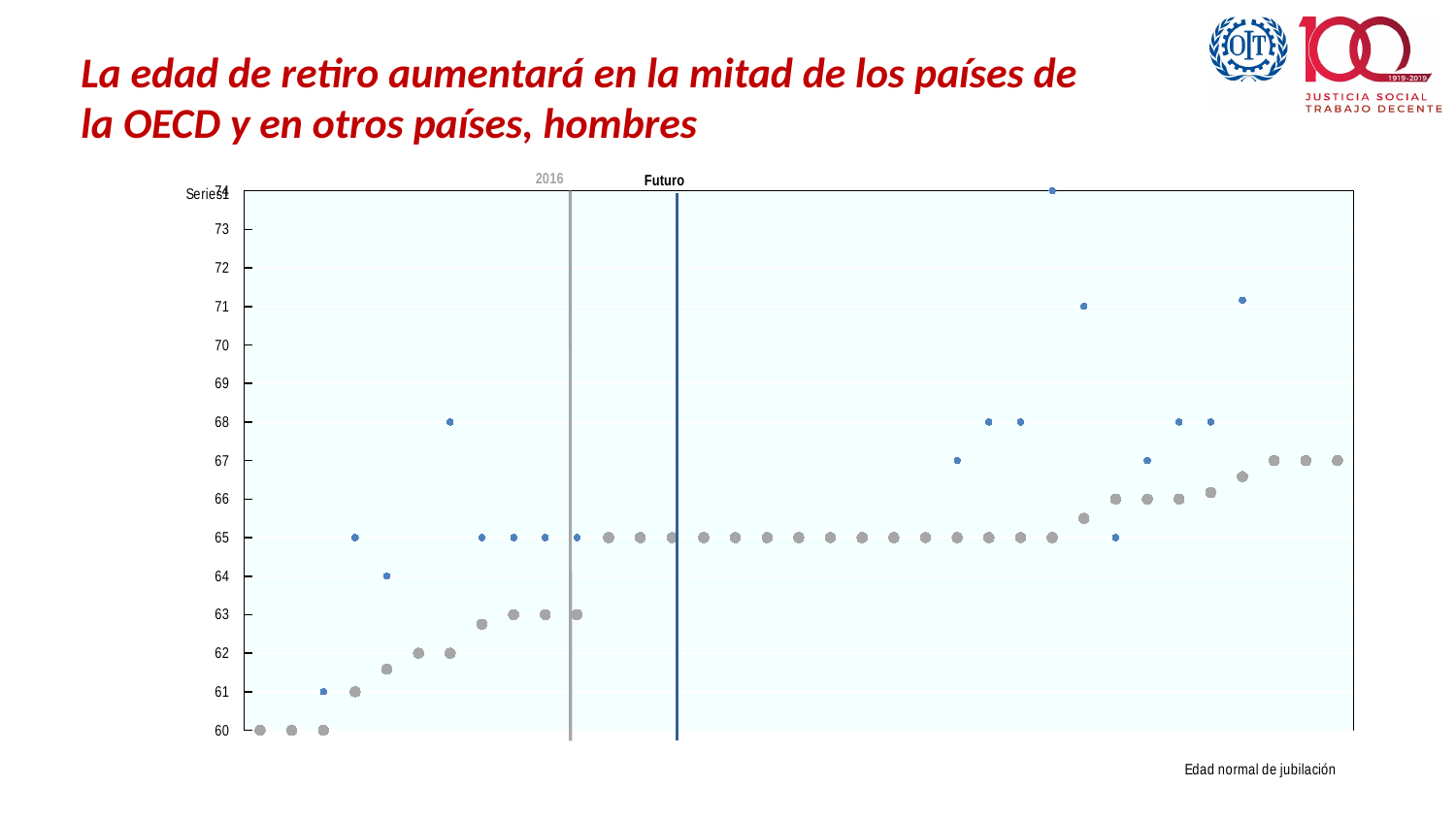
What is the label of the x axis? Edad normal de jubilación Which is larger, the highest blue value or the highest grey value? The highest blue value What is the difference between the highest blue value and the highest grey value? 7 Do the grey dots rise or fall from left to right along the x axis? Rise What is the lowest value plotted on the chart? 60 What are the two labels shown above the vertical reference lines on the chart? 2016 and Futuro What is the highest value plotted on the chart? 74 What is the lowest value reached by the grey dots? 60 What kind of chart is shown on the slide? Scatter (dot) chart What is the highest tick value on the y axis? 74 What is the highest value reached by the grey dots? 67